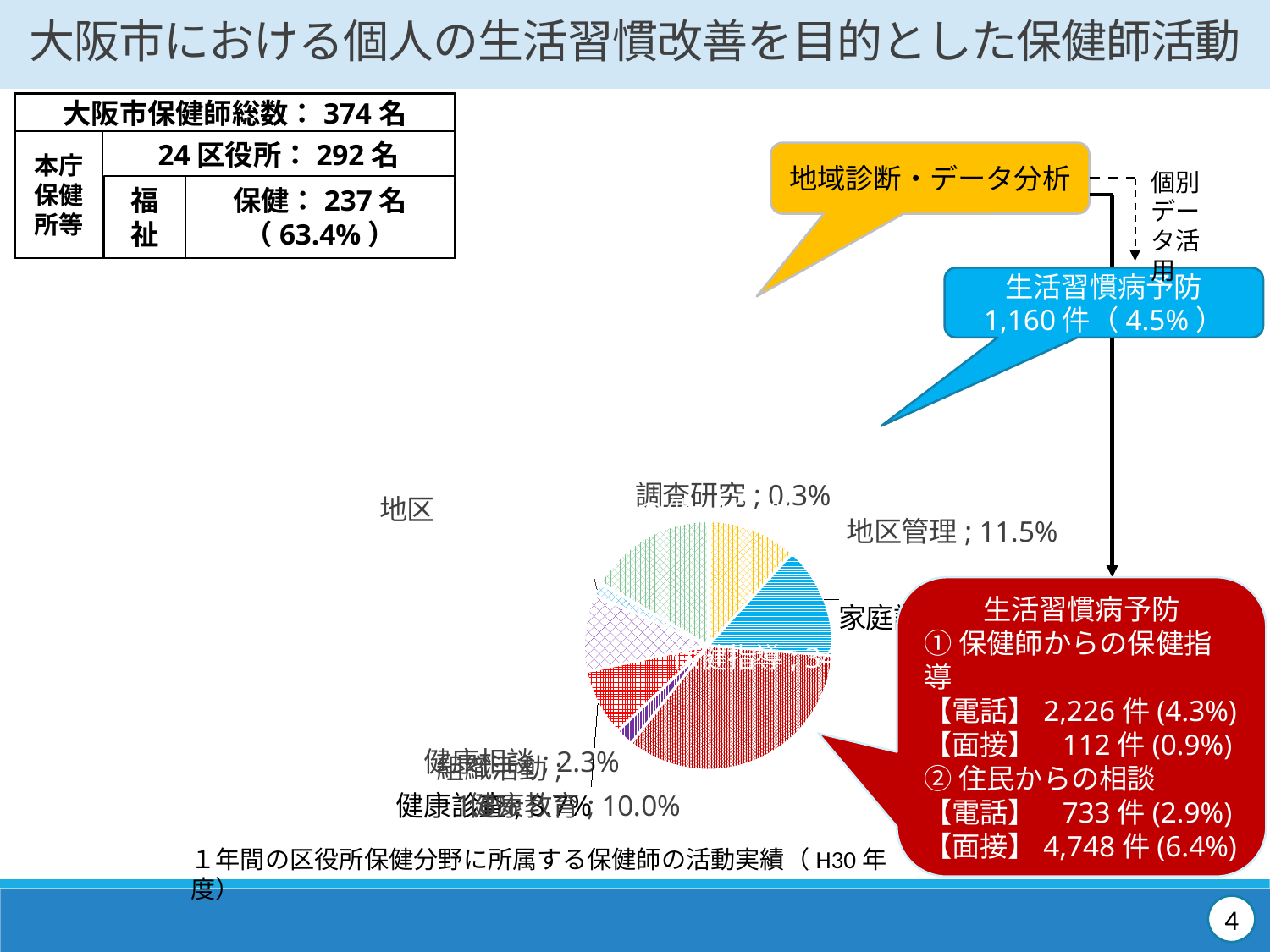
Which fiscal year does the pie chart's caption say the activity results are for? H30年度 What percentage does the pie chart show for 地区管理? 11.5% What kind of chart is shown on the slide? pie chart What is the difference in percentage points between 地区管理 (11.5%) and 調査研究 (0.3%) in the pie chart? 11.2% Which has the larger share in the pie chart, 地区管理 or 調査研究? 地区管理 What percentage does the pie chart show for 調査研究? 0.3%